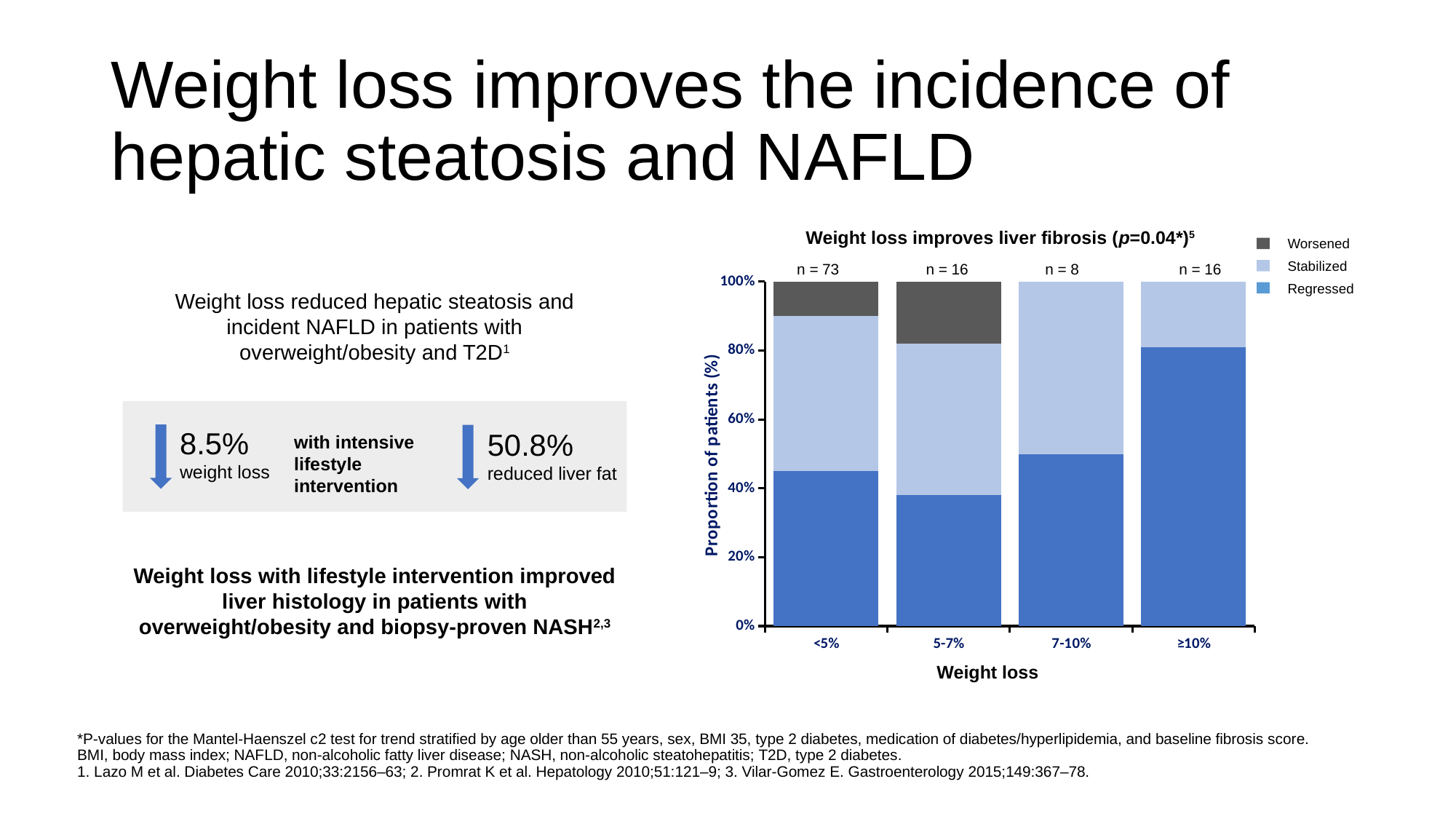
Which weight loss category has the smallest Regressed proportion? 5-7% Is the Regressed proportion for the ≥10% weight loss category greater or less than 60%? greater What is the title of the chart? Weight loss improves liver fibrosis (p=0.04*) What is the n value shown above the 7-10% weight loss bar? n = 8 How many weight loss categories are shown on the x axis of the chart? 4 How many weight loss categories show a Worsened segment? 2 Is the Regressed proportion for the <5% weight loss category greater or less than 40%? greater Which weight loss category has the largest Regressed proportion? ≥10% How many series does the chart legend list? 3 Is the Worsened segment larger for the <5% or the 5-7% weight loss category? 5-7% What is the n value shown above the <5% weight loss bar? n = 73 What kind of chart is shown on the slide? Stacked bar chart